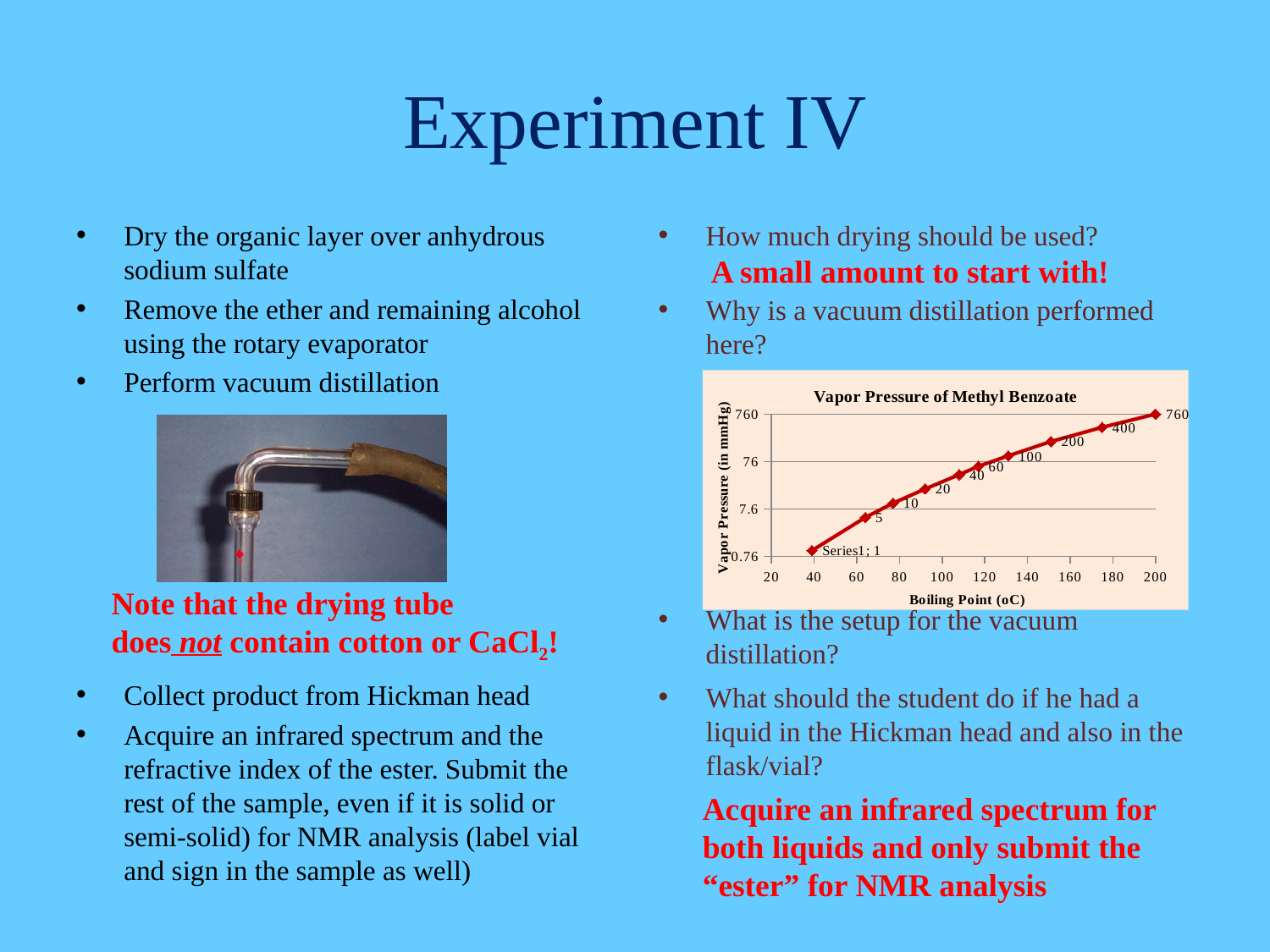
Does the vapor pressure rise or fall as the boiling point increases along the x axis? rise How many data points are plotted on the chart? 10 Is the vapor pressure at a boiling point of 180 oC greater or less than 76 mmHg? greater What is the title of the chart? Vapor Pressure of Methyl Benzoate What is the highest vapor pressure value labelled on the chart? 760 Which is larger, the labelled value 400 or the labelled value 200? 400 Is the vapor pressure at a boiling point of 100 oC greater or less than 76 mmHg? less What is the vapor pressure (in mmHg) at a boiling point of 200 oC? 760 What is the difference between the two highest labelled vapor pressure values, 760 and 400? 360 What is the lowest vapor pressure value labelled on the chart? 1 What kind of chart is shown on the slide? line chart What is the label of the x axis of the chart? Boiling Point (oC)